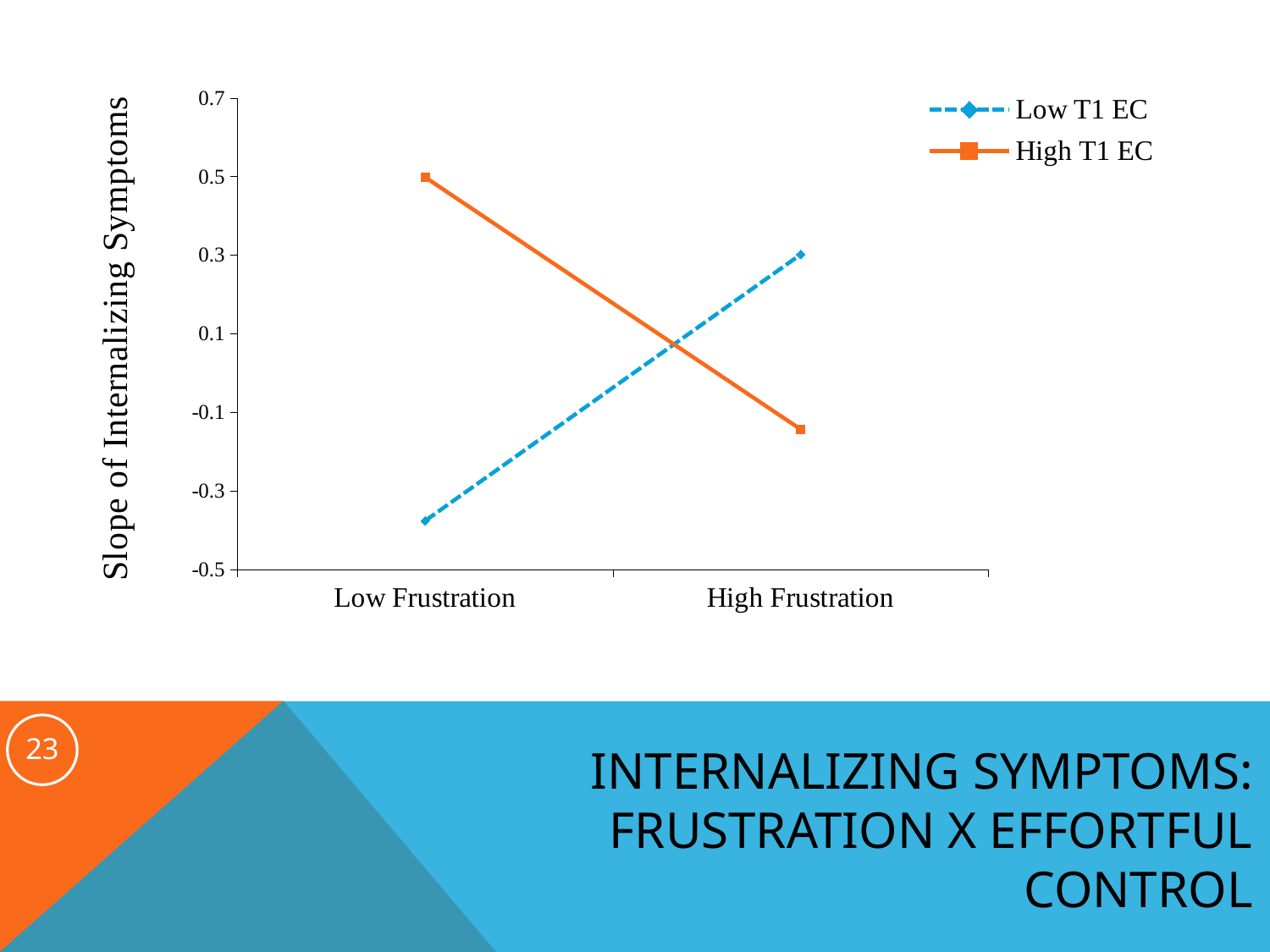
At High Frustration, which series has the higher value, Low T1 EC or High T1 EC? Low T1 EC Does the Low T1 EC line rise or fall from Low Frustration to High Frustration? rises Is the value for High T1 EC at Low Frustration greater or less than 0.3? greater Is the value for High T1 EC at High Frustration greater or less than -0.1? less How many categories are shown on the x axis? 2 What kind of chart is shown on the slide? line chart How many series does the legend list? 2 What is the title of the y axis? Slope of Internalizing Symptoms Is the value for Low T1 EC at Low Frustration greater or less than -0.3? less Does the High T1 EC line rise or fall from Low Frustration to High Frustration? falls Which series and category has the highest plotted value? High T1 EC at Low Frustration At Low Frustration, which series has the higher value, Low T1 EC or High T1 EC? High T1 EC